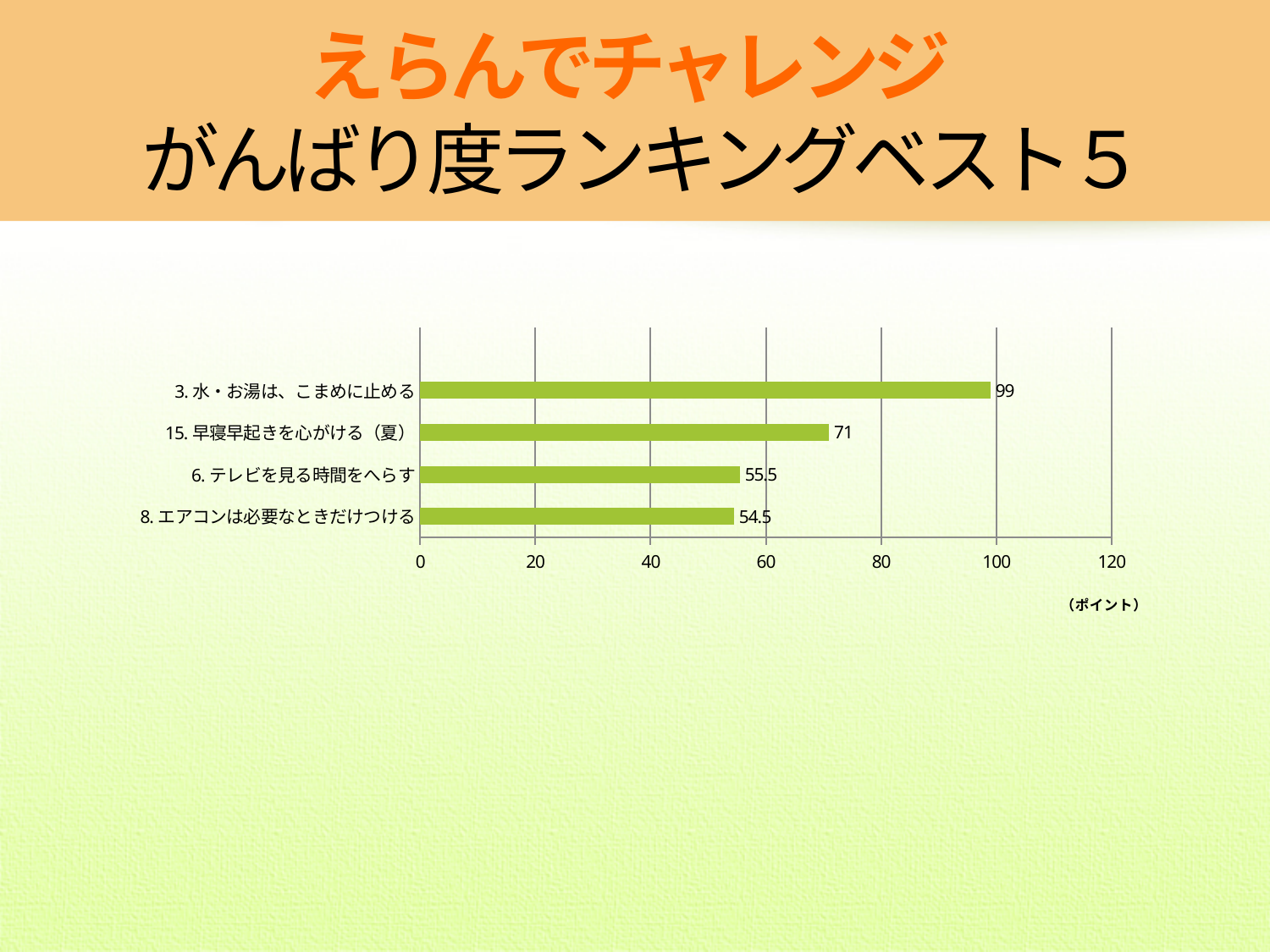
Which category has the highest value? 3. 水・お湯は、こまめに止める What is the difference between the values for 3. 水・お湯は、こまめに止める and 15. 早寝早起きを心がける（夏）? 28 How many categories are shown in the chart? 4 What kind of chart is shown on the slide? Bar chart What is the value for 15. 早寝早起きを心がける（夏）? 71 Which category has the lowest value? 8. エアコンは必要なときだけつける What unit is indicated below the x axis of the chart? （ポイント） What is the value for 6. テレビを見る時間をへらす? 55.5 What is the value for 8. エアコンは必要なときだけつける? 54.5 Which is larger, the value for 15. 早寝早起きを心がける（夏） or the value for 6. テレビを見る時間をへらす? 15. 早寝早起きを心がける（夏） What is the difference between the values for 6. テレビを見る時間をへらす and 8. エアコンは必要なときだけつける? 1 What is the value for 3. 水・お湯は、こまめに止める? 99